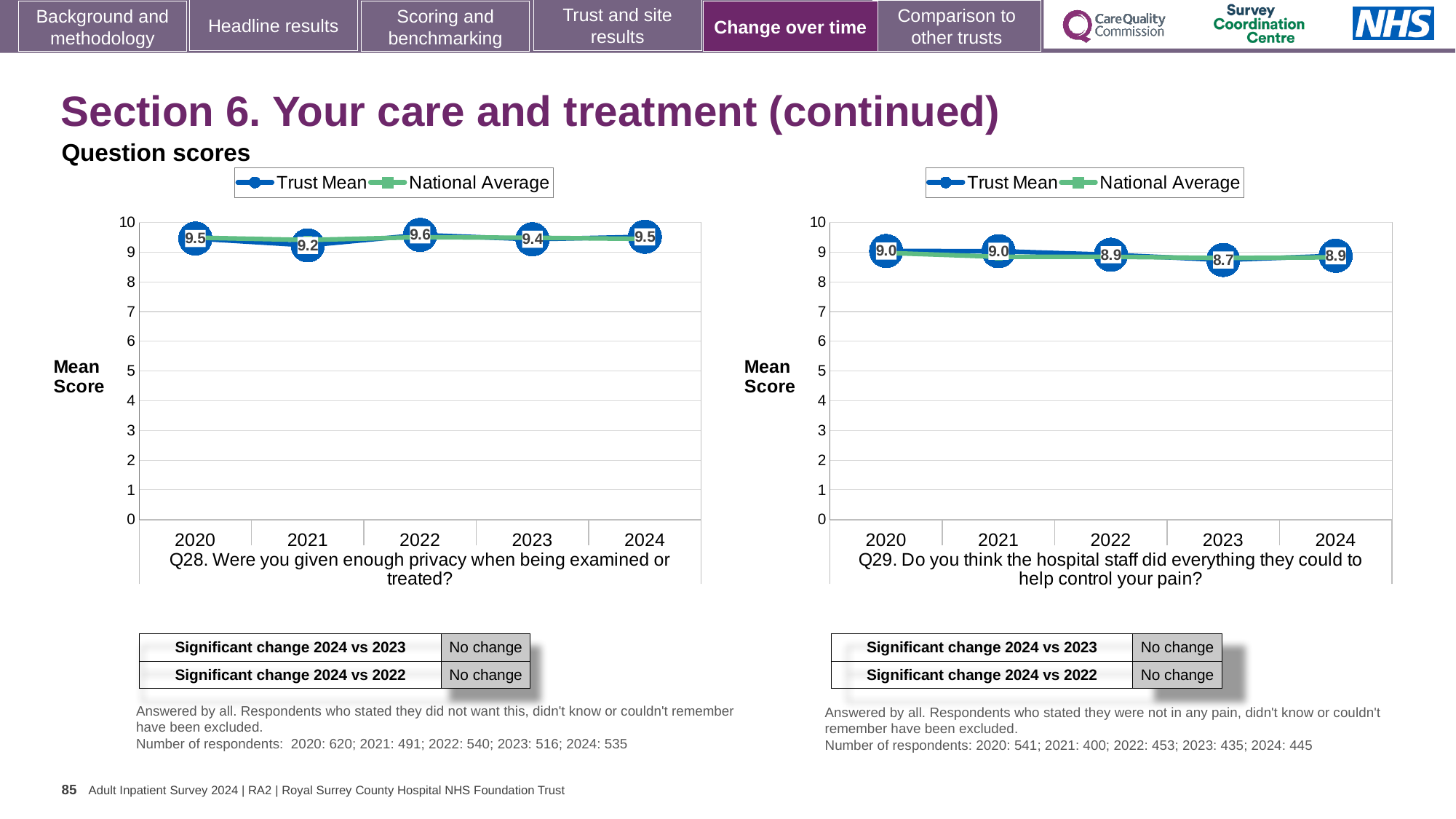
In the Q28 chart (left), what is the Trust Mean score for 2021? 9.2 In the Q28 chart (left), which year has the highest Trust Mean score? 2022 In the Q29 chart (right), what is the Trust Mean score for 2023? 8.7 In the Q29 chart (right), what is the Trust Mean score for 2024? 8.9 In the Q28 chart (left), what is the difference between the Trust Mean scores for 2022 and 2021? 0.4 In the Q28 chart (left), which year has the lowest Trust Mean score? 2021 In the Q28 chart (left), what is the Trust Mean score for 2022? 9.6 In the Q29 chart (right), is the Trust Mean score for 2023 greater or less than 9? less In the Q29 chart (right), which year has the lowest Trust Mean score? 2023 In the Q29 chart (right), what is the difference between the Trust Mean scores for 2020 and 2023? 0.3 What kind of chart is the Q29 chart (right)? Line chart How many years are plotted on the x axis of the Q28 chart (left)? 5